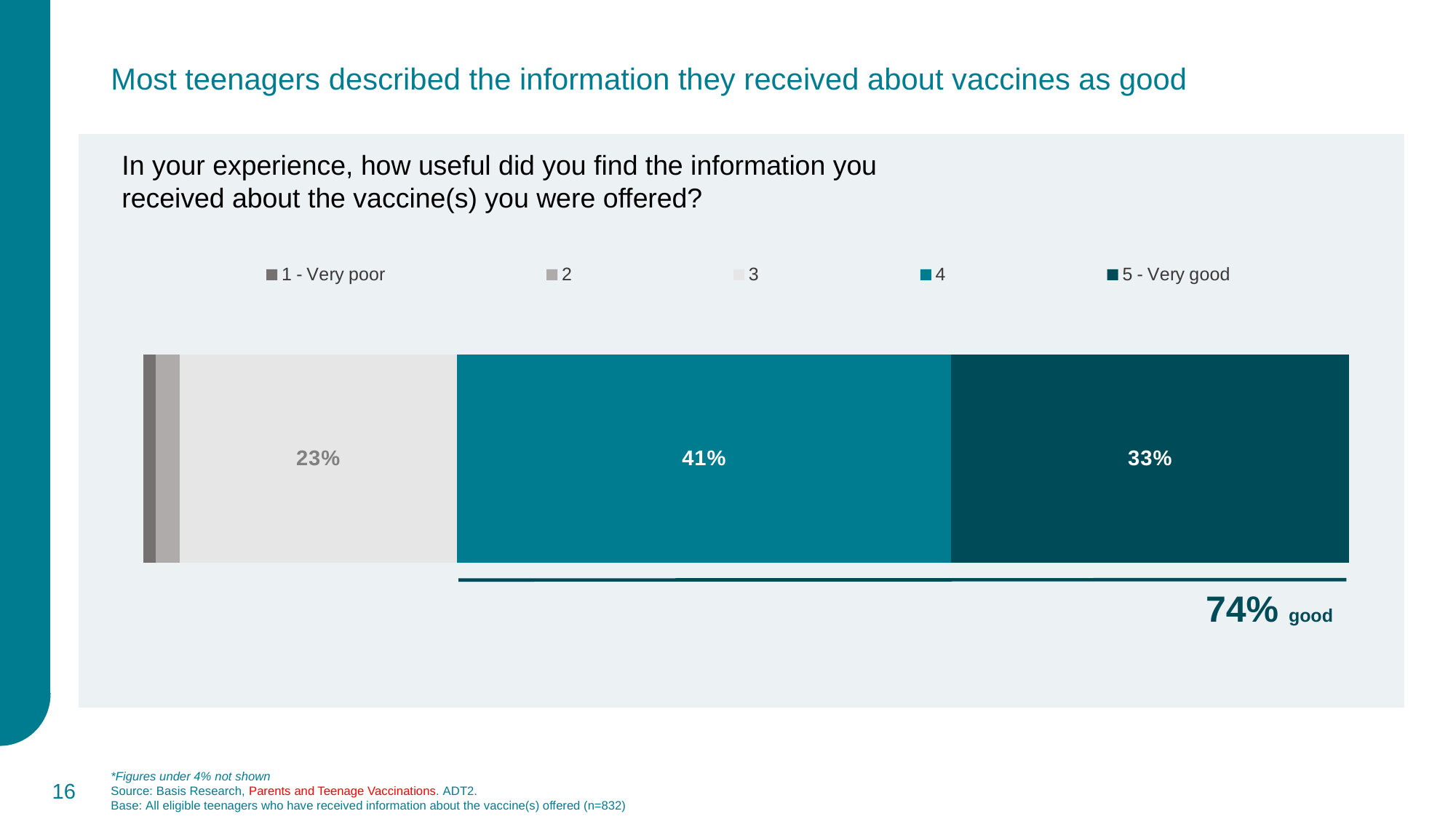
Which is larger: the share rating 3 or the share rating 5 - Very good? 5 - Very good What is the label of the first legend entry? 1 - Very poor Which rating category has the largest share of the bar? 4 How many series does the legend list? 5 What percentage of teenagers rated the information as 5 - Very good? 33% What is the combined share of teenagers who rated the information 4 or 5 - Very good? 74% What kind of chart is shown on the slide? Stacked bar chart What is the difference between the share rating 4 and the share rating 3? 18 percentage points What percentage of teenagers rated the information as 3? 23% What is the difference between the share rating 4 and the share rating 5 - Very good? 8 percentage points What percentage of teenagers rated the information as 4? 41% According to the footnote, figures below what value are not shown on the chart? 4%